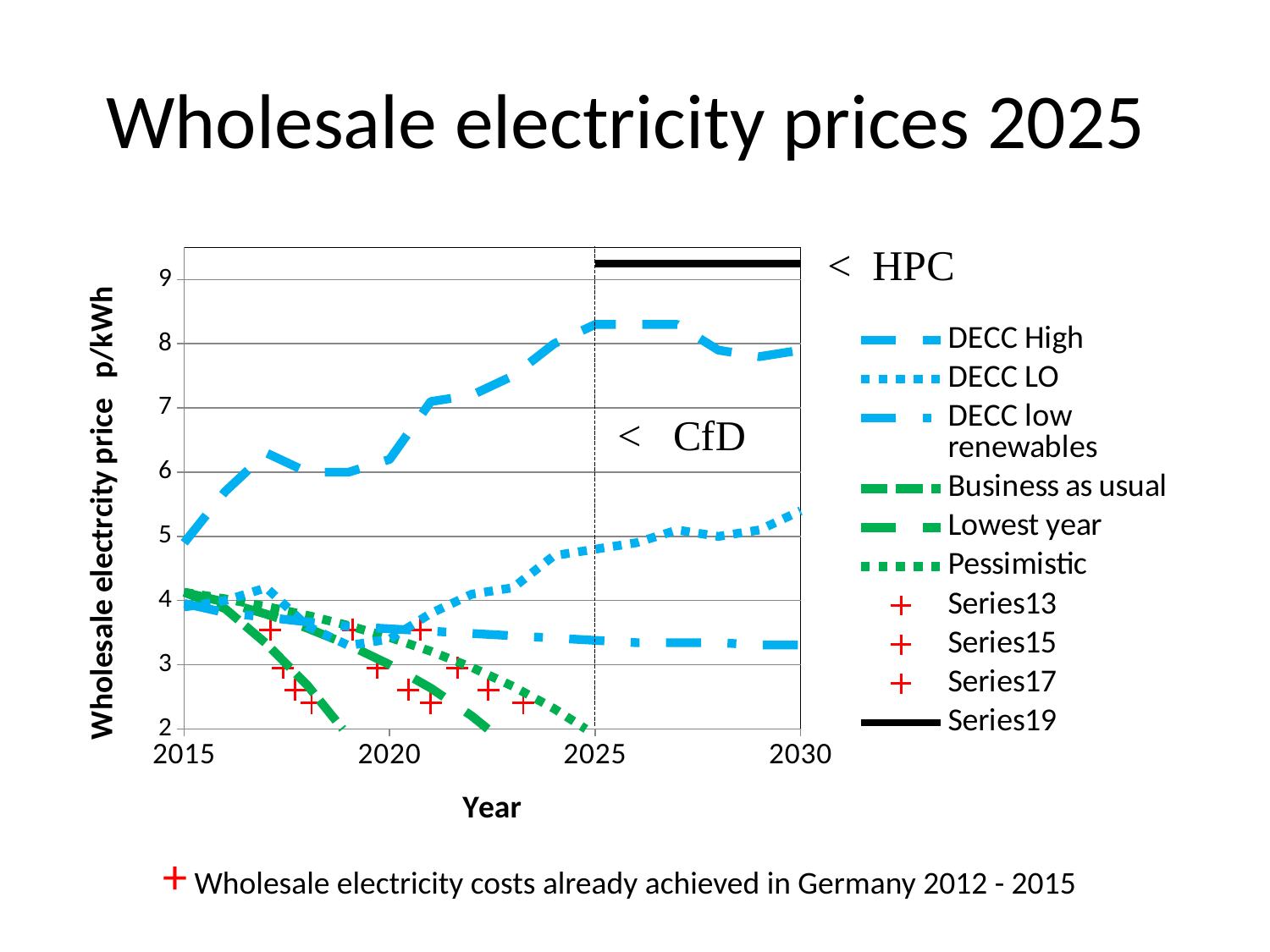
What is the title of the slide's chart? Wholesale electricity prices 2025 Is the value of DECC low renewables in 2030 greater or less than 4? less Is the value of DECC LO in 2030 greater or less than 5? greater Does the DECC High series rise or fall between 2015 and 2025? rise How many series does the chart legend list? 10 How many year labels are shown on the x axis? 4 Is the value of the Series19 line greater or less than 9? greater What kind of chart is shown on the slide? line chart Does the Business as usual series rise or fall from 2015 onwards? fall What is the label of the x axis? Year Which is higher in 2025, DECC High or DECC LO? DECC High